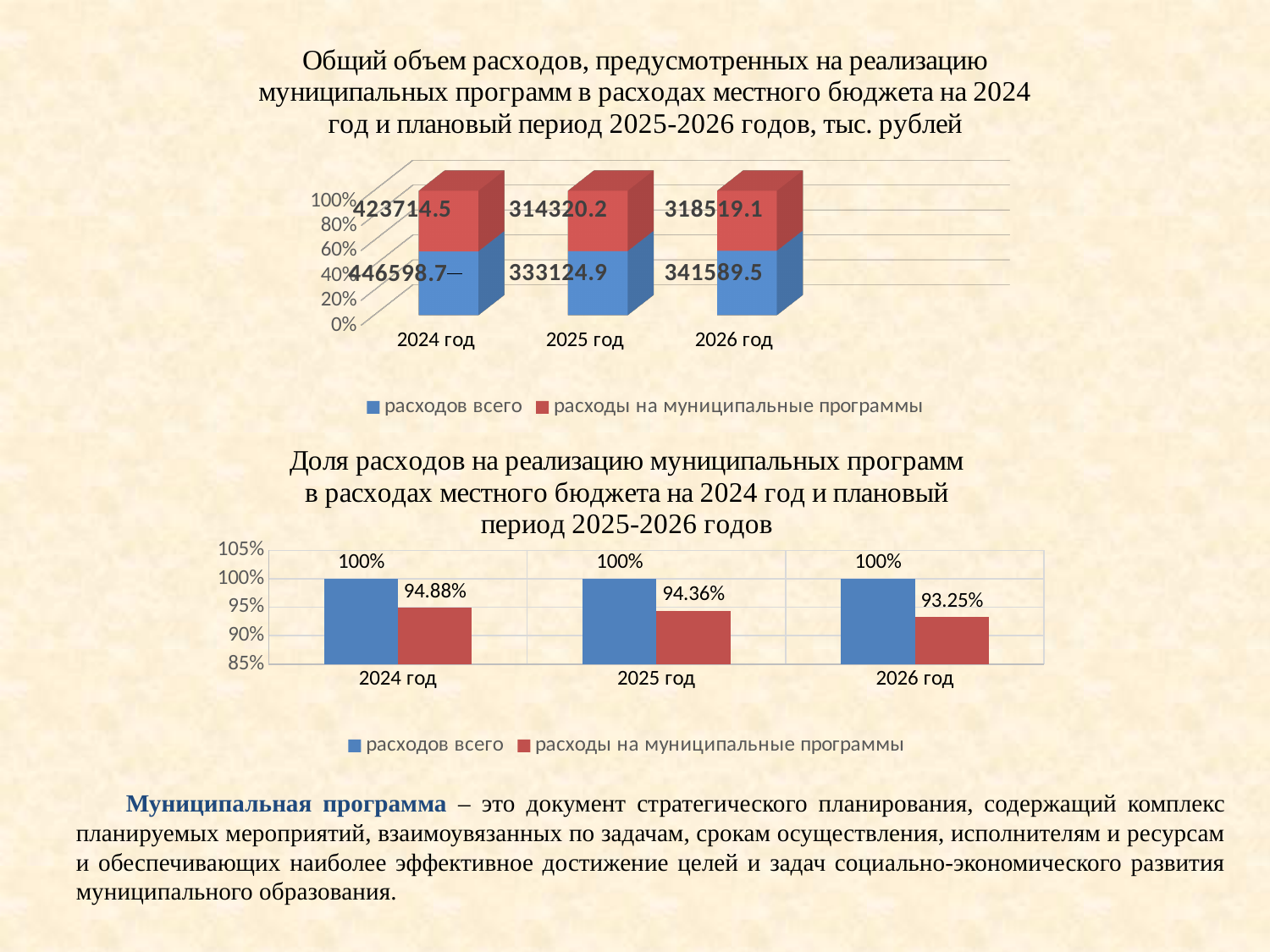
In the top chart, which is larger: 'расходов всего' in 2025 год or 'расходов всего' in 2026 год? 2026 год In the top chart, what is the difference between 'расходов всего' and 'расходы на муниципальные программы' in 2024 год? 22884.2 In the top chart, which year has the highest value for 'расходов всего'? 2024 год In the bottom chart, what is the difference between 'расходов всего' and 'расходы на муниципальные программы' in 2026 год? 6.75% In the top chart, which year has the lowest value for 'расходы на муниципальные программы'? 2025 год In the top chart, what is the value for 'расходы на муниципальные программы' in 2025 год? 314320.2 What kind of chart is the bottom chart? Bar chart In the top chart, what is the value for 'расходов всего' in 2024 год? 446598.7 In the top chart, what is the value for 'расходы на муниципальные программы' in 2026 год? 318519.1 How many series does the legend of the top chart list? 2 In the bottom chart, how does the value for 'расходы на муниципальные программы' change from 2024 год to 2026 год? It falls In the bottom chart, what is the value for 'расходы на муниципальные программы' in 2025 год? 94.36%